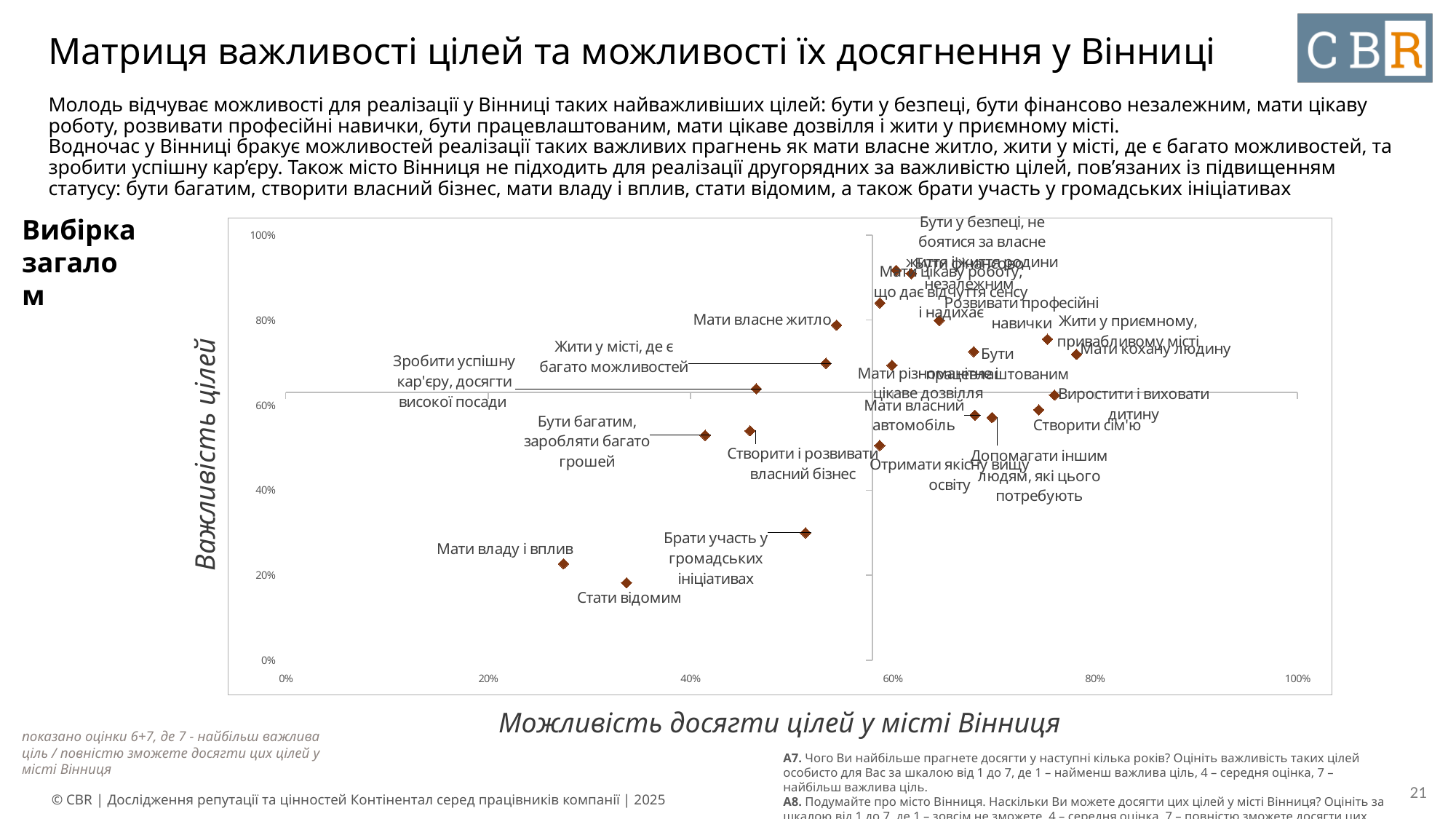
What is the title of the chart on the slide? Матриця важливості цілей та можливості їх досягнення у Вінниці Which goal has the lowest possibility of achievement (leftmost position on the horizontal axis)? Мати владу і вплив What is the label of the horizontal axis of the chart? Можливість досягти цілей у місті Вінниця Which goal has a higher possibility-of-achievement value: "Мати кохану людину" or "Мати владу і вплив"? Мати кохану людину Is the possibility-of-achievement value for "Мати кохану людину" greater or less than 60%? greater Is the possibility-of-achievement value for "Стати відомим" greater or less than 40%? less Is the importance value for "Бути у безпеці, не боятися за власне життя і життя родини" greater or less than 80%? greater What kind of chart is shown on the slide? Scatter chart Which goal has a higher importance value: "Мати власне житло" or "Стати відомим"? Мати власне житло